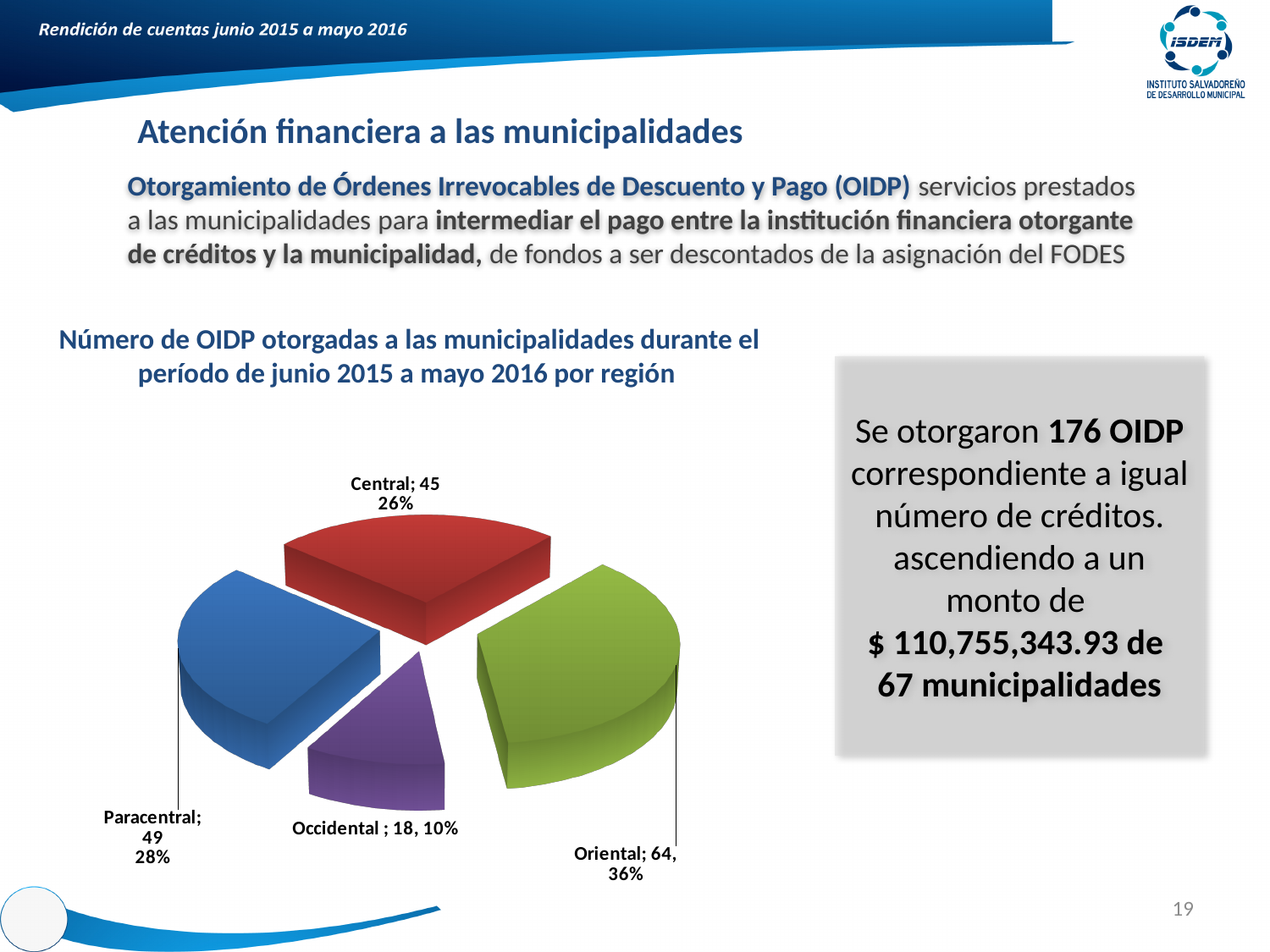
What share of the OIDP does the Paracentral region represent? 28% Which region received the lowest number of OIDP? Occidental How many OIDP were granted in the Central region? 45 How many OIDP were granted in the Oriental region? 64 How many OIDP were granted in the Occidental region? 18 Which region received the highest number of OIDP? Oriental How many regions (slices) does the pie chart show? 4 How many OIDP were granted in the Paracentral region? 49 What is the difference between the number of OIDP in the Oriental and Central regions? 19 What share of the OIDP does the Oriental region represent? 36% What kind of chart is shown on the slide? Pie chart Which region received more OIDP, Paracentral or Central? Paracentral